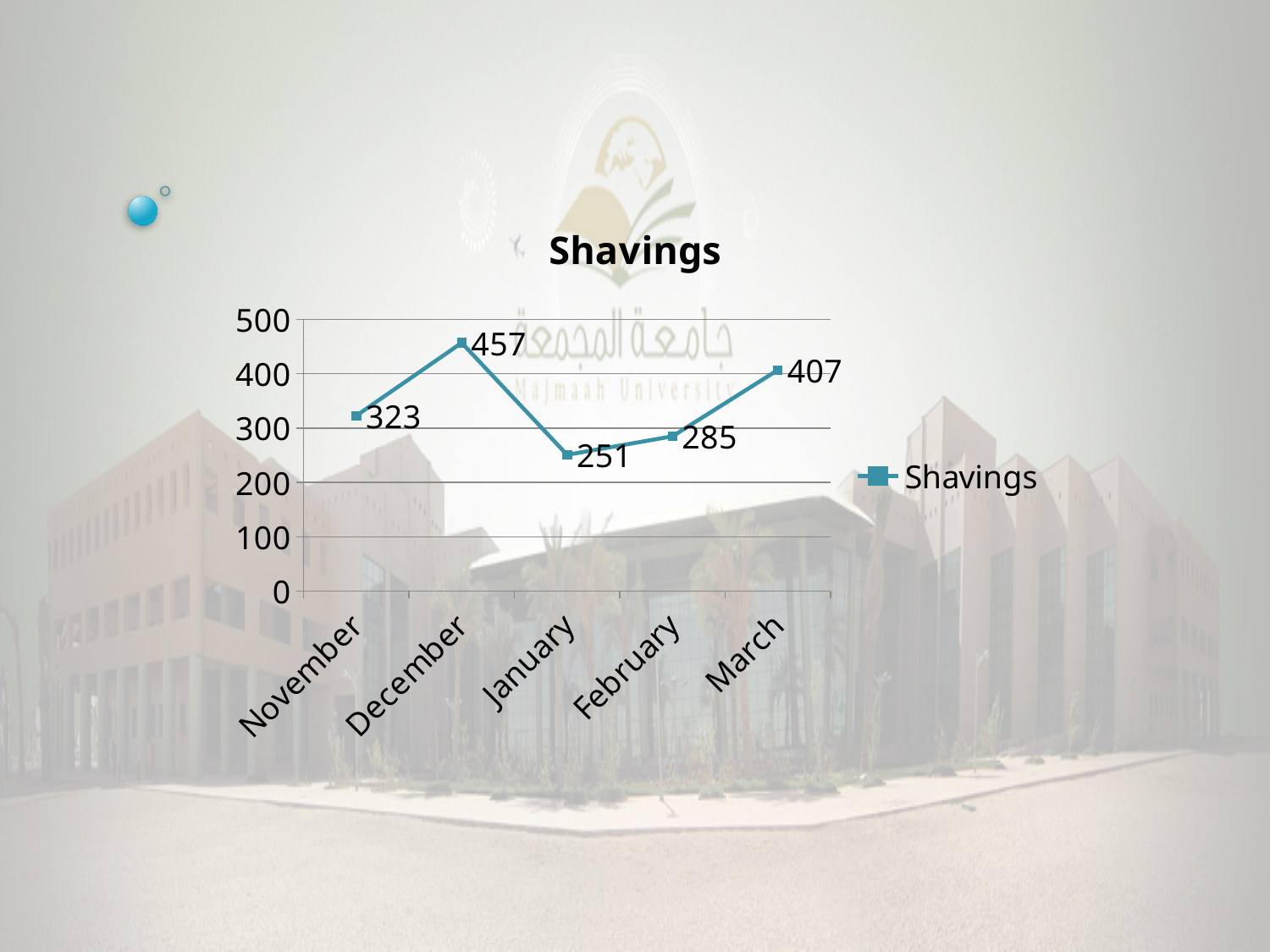
How many series does the legend list? 1 Which month has the lowest value? January Is the value for February greater or less than 300? less Which month has the highest value? December What is the difference between the December and January values? 206 What is the value for January? 251 What is the value for December? 457 What is the title of the chart? Shavings How many months are plotted on the chart? 5 What kind of chart is shown? line chart Which is larger, the value for November or the value for February? November What is the value for March? 407